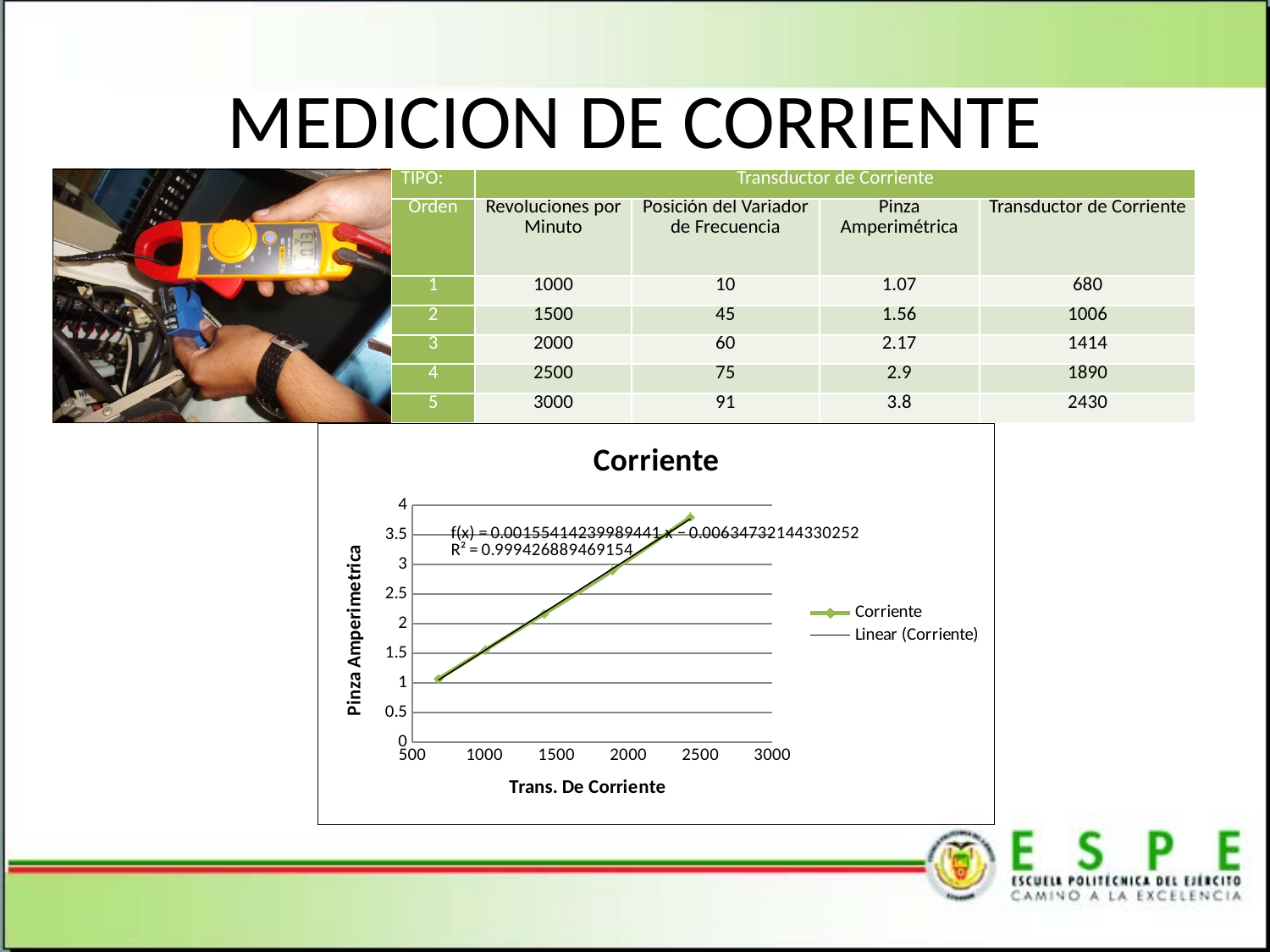
On the "Corriente" chart, is the Pinza Amperimetrica value of the highest point greater or less than 3.5? greater On the "Corriente" chart, is the Pinza Amperimetrica value of the lowest point greater or less than 1.5? less Do the values on the "Corriente" chart rise or fall as Trans. De Corriente increases? rise What kind of chart is the "Corriente" chart? line chart What is the x-axis title of the "Corriente" chart? Trans. De Corriente How many series does the legend of the "Corriente" chart list? 2 On the "Corriente" chart, which point has the higher Pinza Amperimetrica value: the one near 1000 or the one near 2400 on the x axis? the one near 2400 On the "Corriente" chart, is the Pinza Amperimetrica value of the point near 1400 on the x axis greater or less than 2? greater How many data points are plotted on the "Corriente" chart? 5 What is the R² value shown on the "Corriente" chart? 0.999426889469154 According to the table, what Pinza Amperimétrica value corresponds to a Transductor de Corriente reading of 2430, the highest point on the "Corriente" chart? 3.8